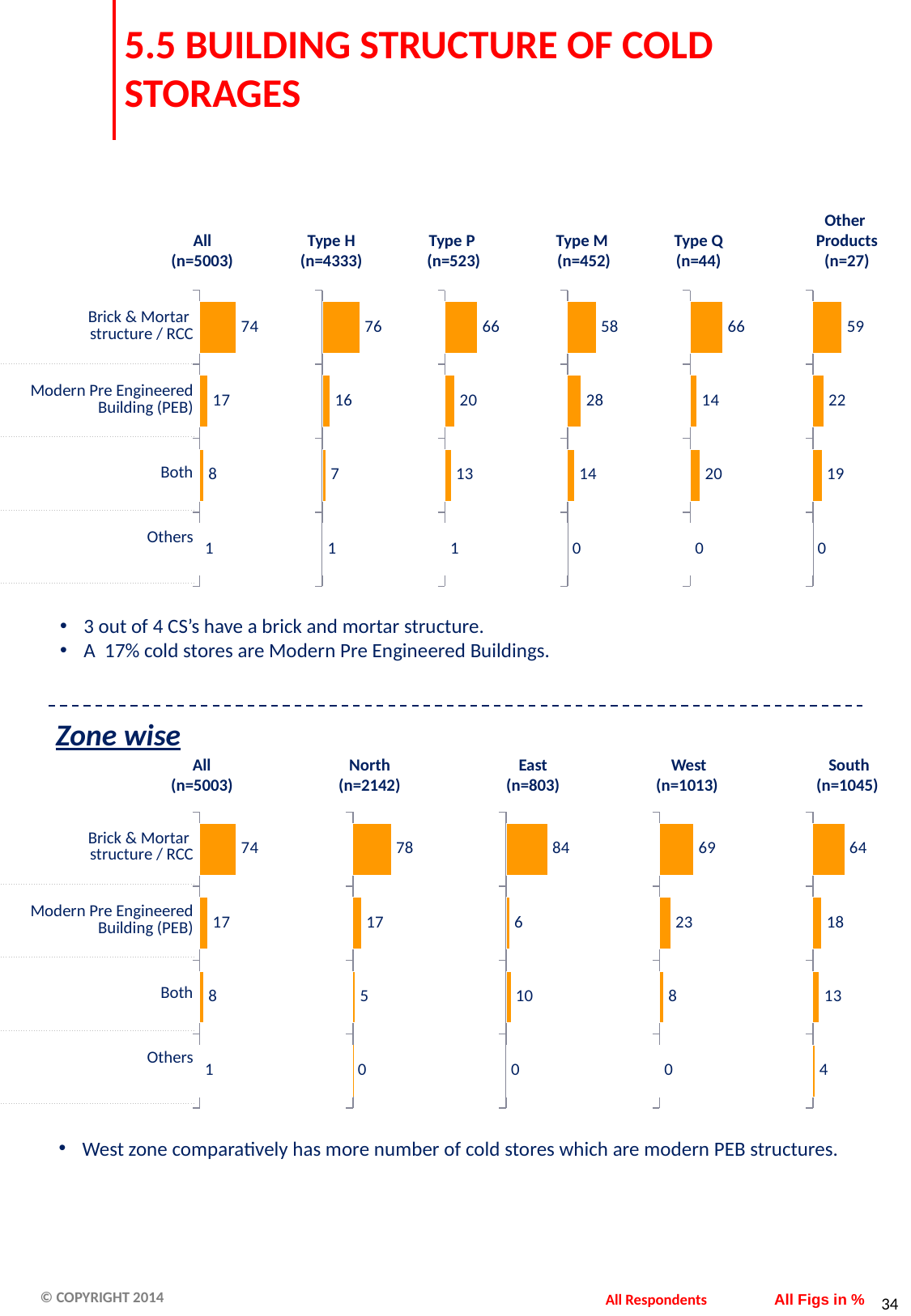
In the top set of charts (by type), what is the value for Modern Pre Engineered Building (PEB) in the Type P (n=523) chart? 20 In the Zone wise charts, what is the difference between Brick & Mortar structure / RCC and Both in the North (n=2142) chart? 73 In the top set of charts (by type), which is larger for Both: Type Q (n=44) or Type P (n=523)? Type Q (n=44) What kind of chart is used in the Zone wise section? Bar chart In the top set of charts (by type), what is the difference between Brick & Mortar structure / RCC and Modern Pre Engineered Building (PEB) in the Type H (n=4333) chart? 60 In the Zone wise charts, what is the value for Others in the South (n=1045) chart? 4 In the top set of charts (by type), which category has the lowest value in the Other Products (n=27) chart? Others In the Zone wise charts, which zone has the highest value for Modern Pre Engineered Building (PEB)? West (n=1013) In the top set of charts (by type), what is the value for Brick & Mortar structure / RCC in the Type M (n=452) chart? 58 How many categories are shown in each of the Zone wise charts? 4 In the top set of charts (by type), which category has the highest value in the Type Q (n=44) chart? Brick & Mortar structure / RCC In the Zone wise charts, what is the value for Brick & Mortar structure / RCC in the East (n=803) chart? 84